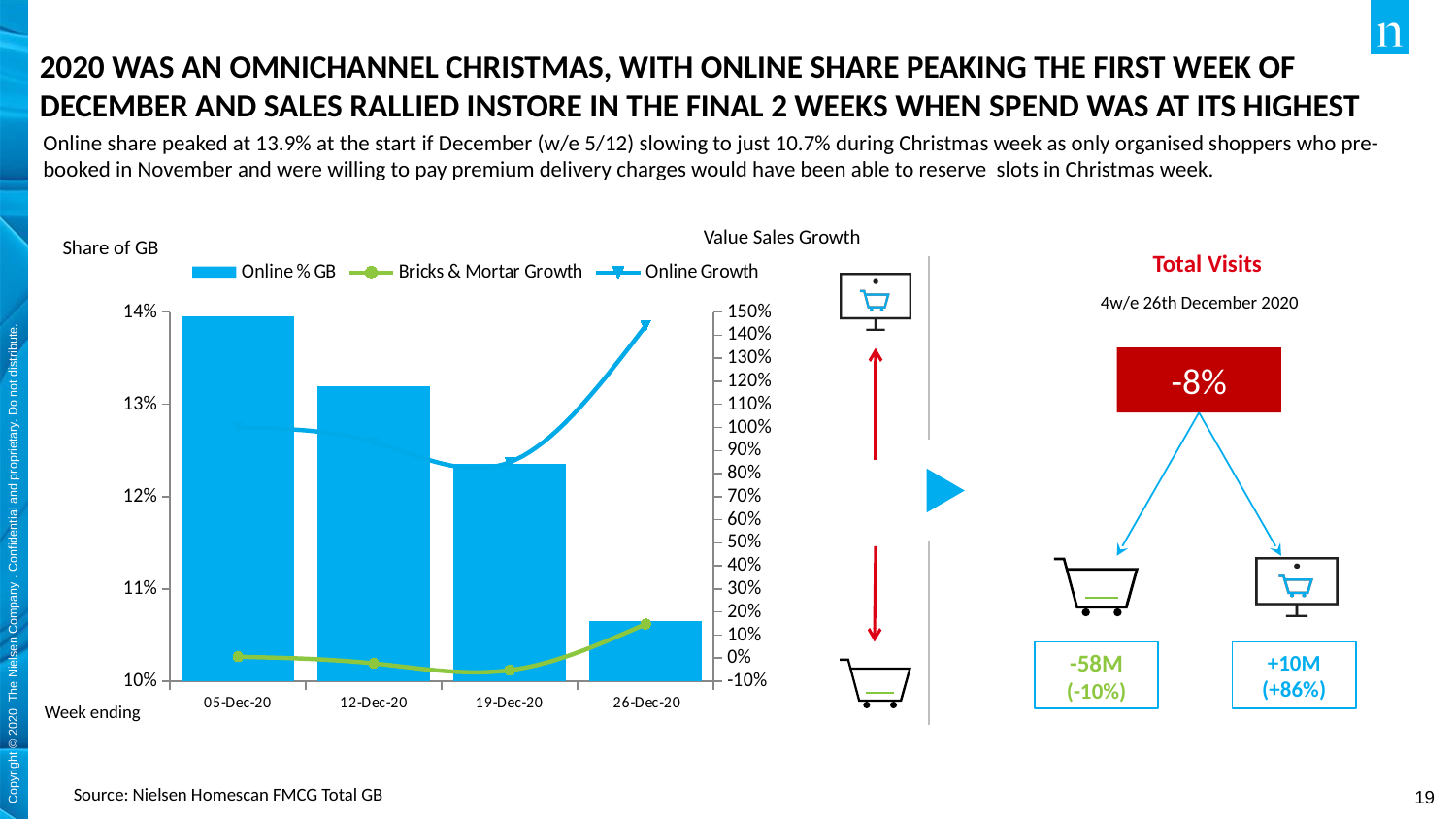
At 26-Dec-20, which is larger: Online Growth or Bricks & Mortar Growth? Online Growth How many week-ending categories are shown on the x axis of the chart? 4 How many series does the chart legend list? 3 Is the Online % GB value for 26-Dec-20 greater or less than 11%? less Which week ending has the highest Online Growth value? 26-Dec-20 Which week ending has the highest Online % GB bar? 05-Dec-20 What kind of chart is shown on the slide? A combination bar and line chart Is the Online % GB value for 12-Dec-20 greater or less than 13%? greater Is the Online Growth value for 26-Dec-20 greater or less than 100%? greater Do the Online % GB bars rise or fall from 05-Dec-20 to 26-Dec-20? Fall Which week ending has the lowest Online % GB bar? 26-Dec-20 What is the title of the left-hand vertical axis of the chart? Share of GB